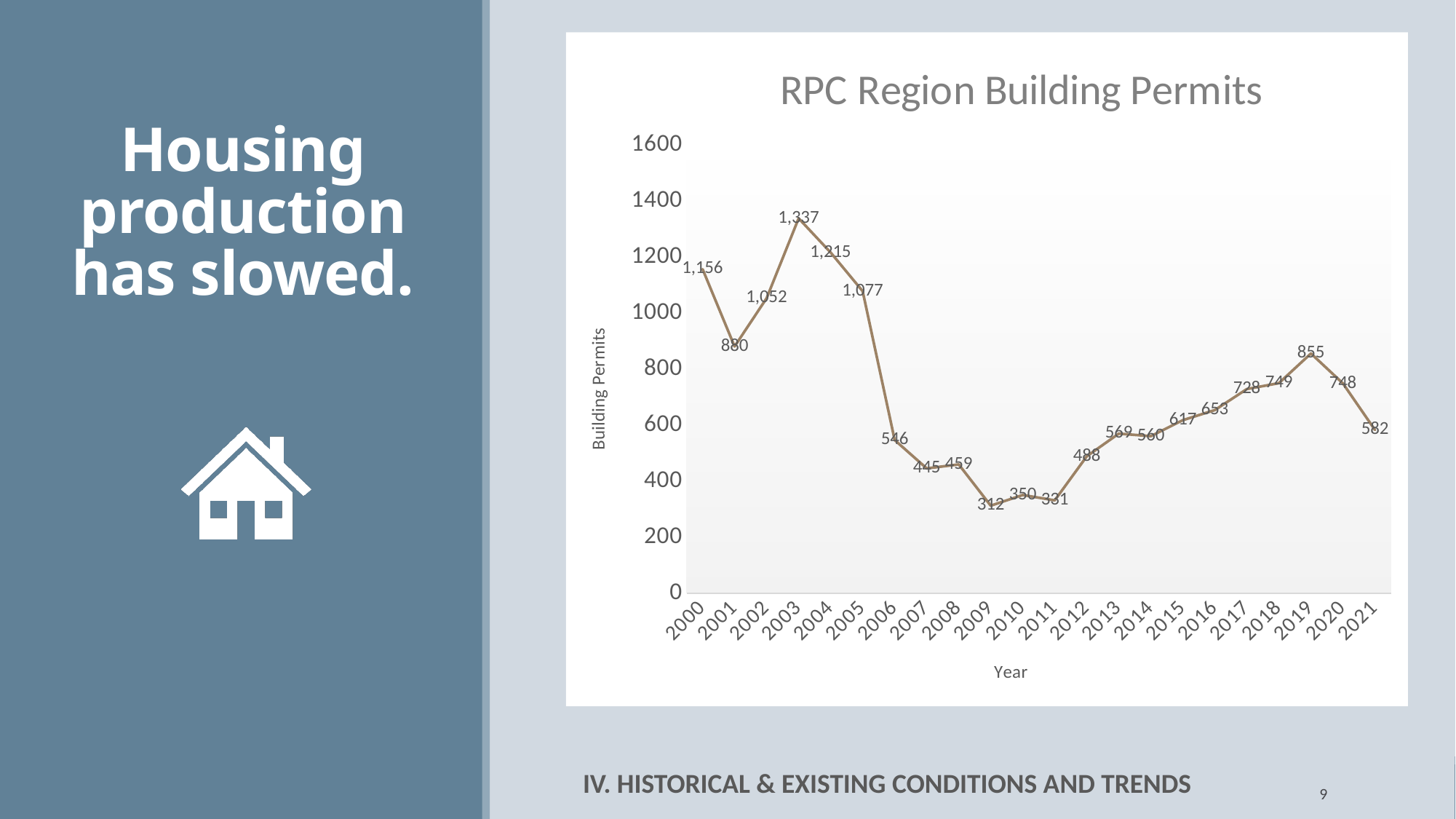
What is the number of building permits in 2021? 582 What is the difference in building permits between 2019 and 2020? 107 Which year had more building permits, 2006 or 2012? 2006 How many years are plotted on the chart? 22 Is the value for 2016 greater or less than 600? greater What kind of chart is shown on the slide? Line chart What is the number of building permits in 2009? 312 What is the number of building permits in 2003? 1,337 Which year has the lowest number of building permits? 2009 What is the title of the chart? RPC Region Building Permits Do building permits rise or fall from 2012 to 2019? Rise Which year has the highest number of building permits? 2003